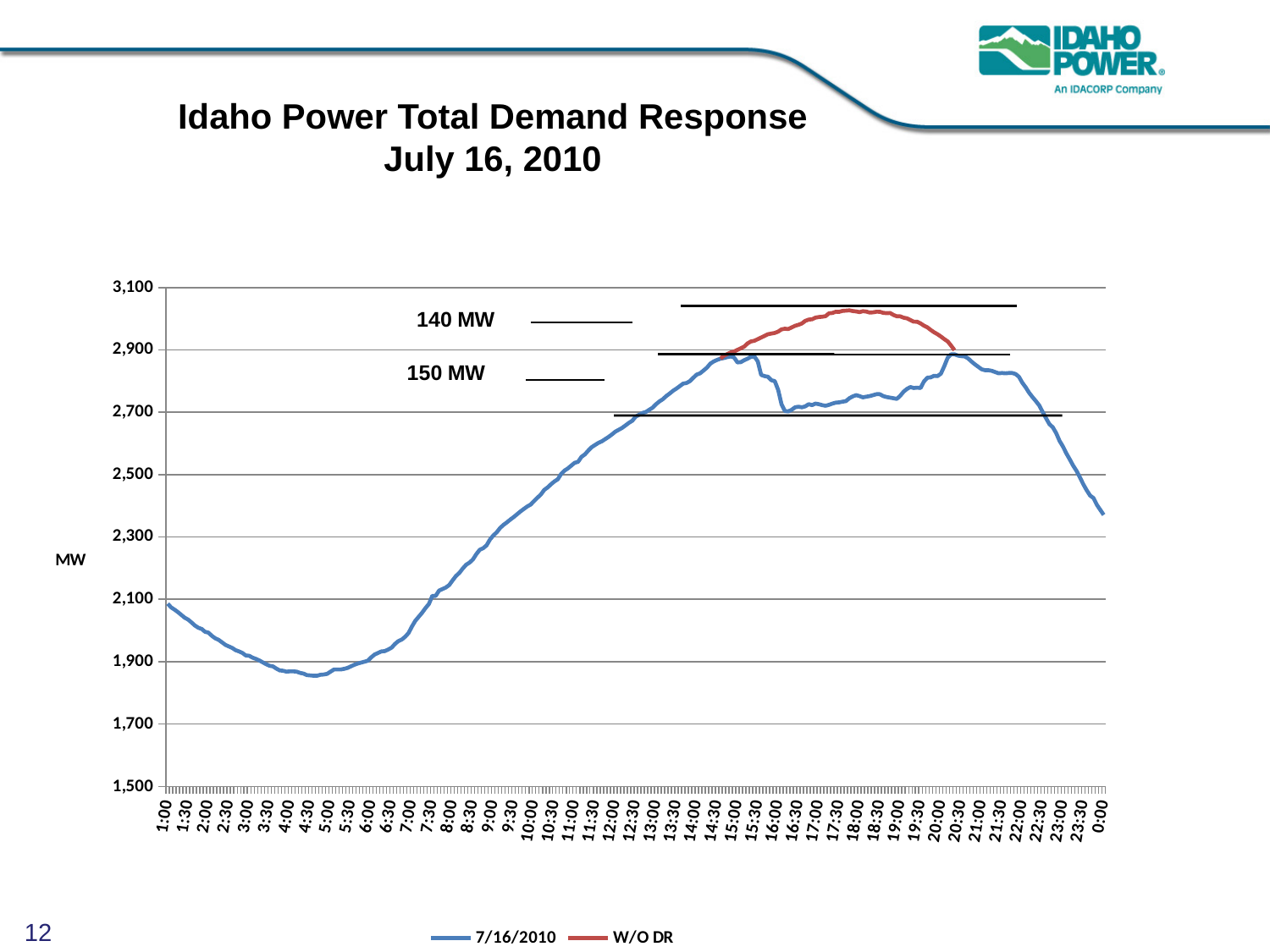
What kind of chart is shown on the slide? line chart Does the 7/16/2010 line rise or fall between 5:00 and 14:30? rise What two MW values are annotated on the chart between the horizontal reference lines? 140 MW and 150 MW Is the 7/16/2010 value at 4:30 greater or less than 1,900? less What are the two series named in the legend? 7/16/2010 and W/O DR Is the 7/16/2010 value at 16:30 greater or less than 2,900? less Is the 7/16/2010 value at 12:00 greater or less than 2,500? greater Does the 7/16/2010 line rise or fall between 1:00 and 4:30? fall At 18:00, which series has the higher value, 7/16/2010 or W/O DR? W/O DR How many series does the legend list? 2